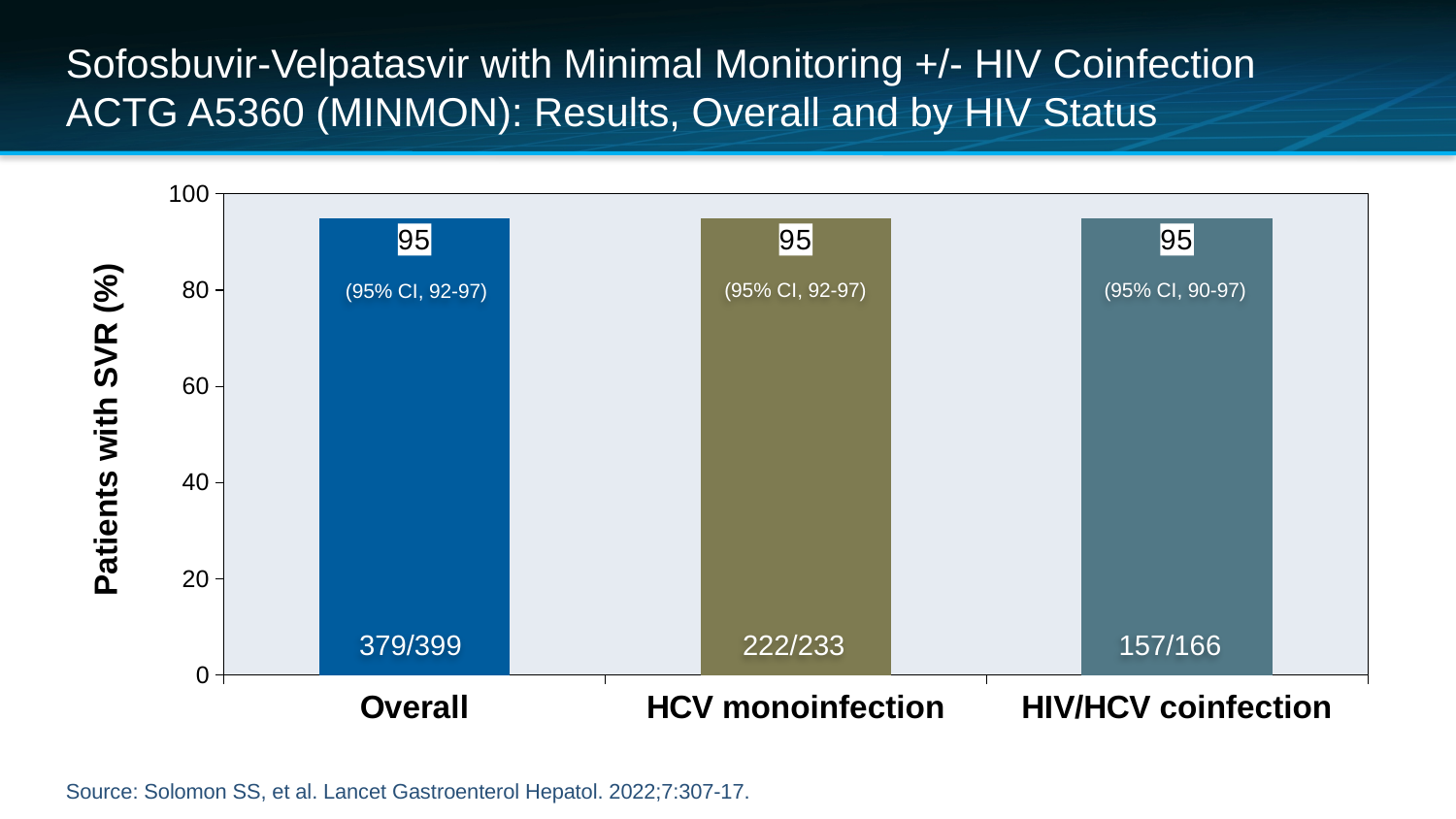
What is the 95% CI shown for the Overall group? 95% CI, 92-97 What is the SVR rate (%) for the HIV/HCV coinfection group? 95 What kind of chart is shown on the slide? Bar chart How many groups are shown on the x axis of the chart? 3 How many patients achieved SVR out of the total in the HCV monoinfection group, as printed on the bar? 222/233 Is the SVR rate for the HIV/HCV coinfection group greater or less than 80? greater What is the SVR rate (%) for the HCV monoinfection group? 95 What fraction is printed on the Overall bar? 379/399 What fraction is printed on the HIV/HCV coinfection bar? 157/166 What is the 95% CI shown for the HIV/HCV coinfection group? 95% CI, 90-97 What is the SVR rate (%) for the Overall group? 95 What is the difference in SVR rate (%) between the HCV monoinfection and HIV/HCV coinfection groups? 0